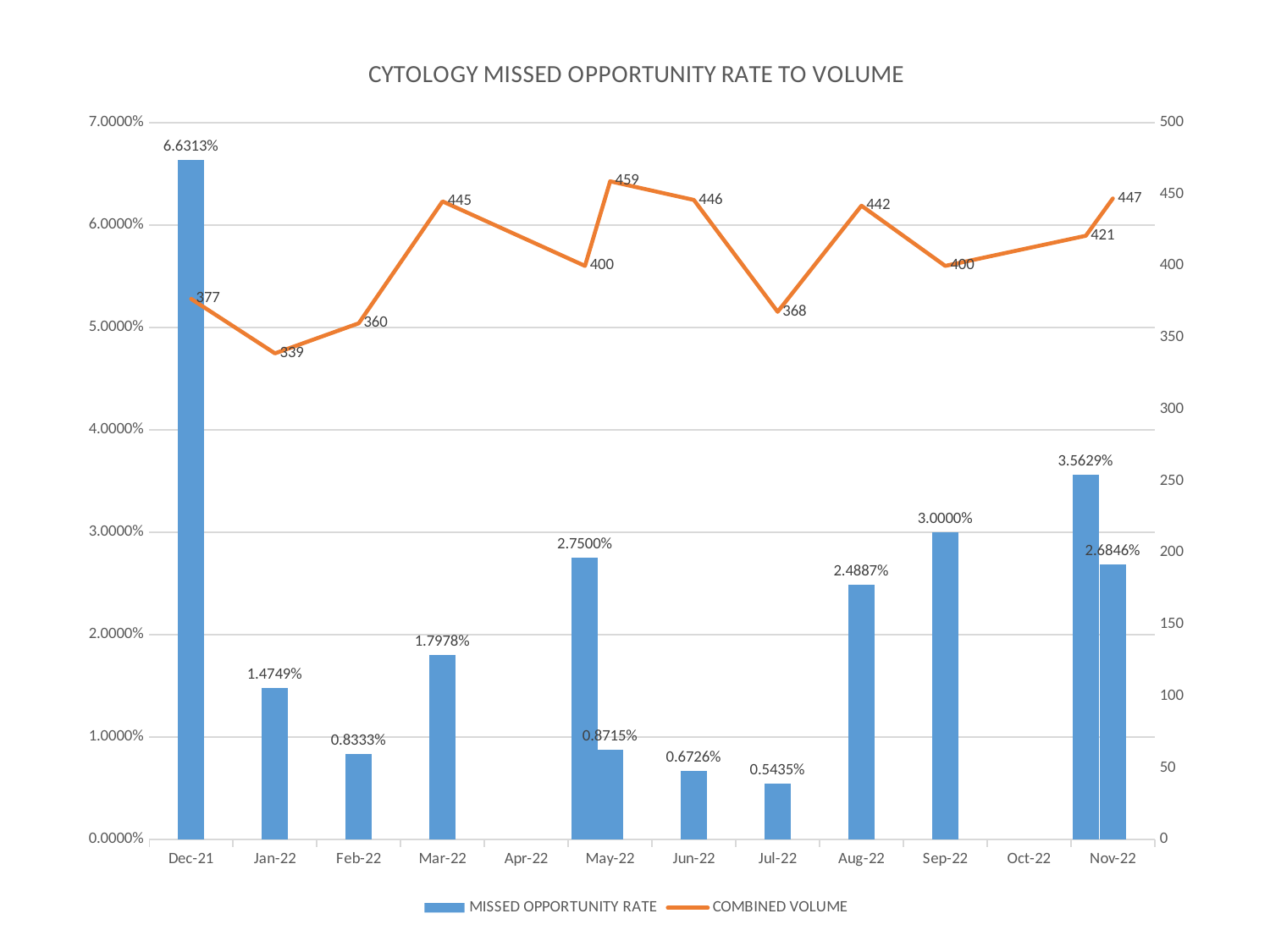
Which month has the lowest missed opportunity rate? Jul-22 Which has a higher missed opportunity rate, Aug-22 or Jan-22? Aug-22 What is the combined volume for Jan-22? 339 What is the title of the chart? CYTOLOGY MISSED OPPORTUNITY RATE TO VOLUME Which month has the highest missed opportunity rate? Dec-21 What is the missed opportunity rate for Sep-22? 3.0000% What is the combined volume for Mar-22? 445 What is the lowest combined volume value shown on the line? 339 How many series does the legend list? 2 What is the difference in combined volume between Mar-22 and Feb-22? 85 What is the missed opportunity rate for Dec-21? 6.6313% Is the combined volume for Jul-22 greater or less than 400? less